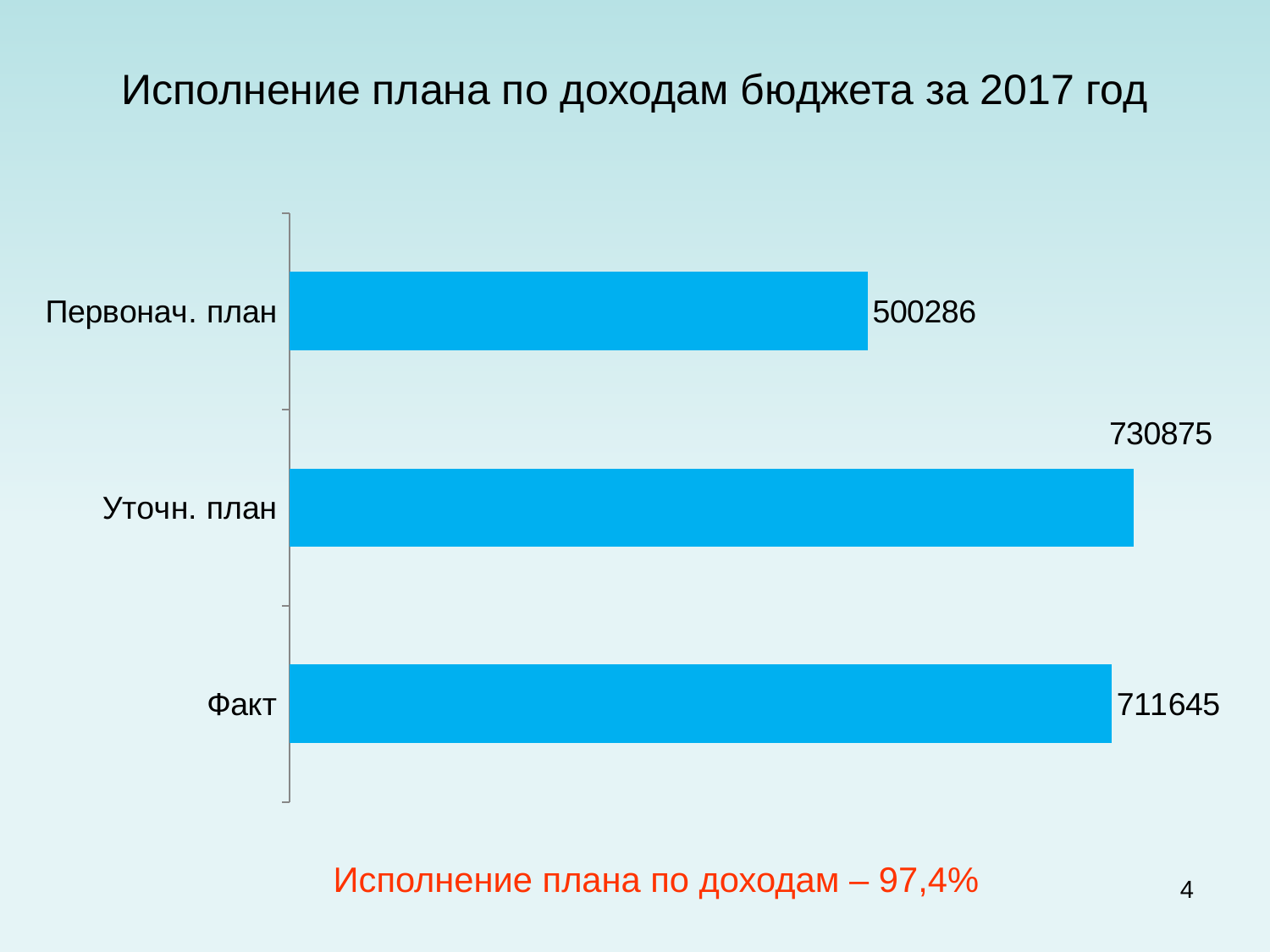
What is the value for Уточн. план? 730875 What is the value for Факт? 711645 Which category has the highest value? Уточн. план How many categories are shown in the chart? 3 What is the title of the slide? Исполнение плана по доходам бюджета за 2017 год What is the difference between Факт and Первонач. план? 211359 What is the difference between Уточн. план and Факт? 19230 What kind of chart is shown on the slide? Bar chart What is the value for Первонач. план? 500286 Which is larger, Уточн. план or Факт? Уточн. план Which category has the lowest value? Первонач. план Which is larger, Первонач. план or Факт? Факт